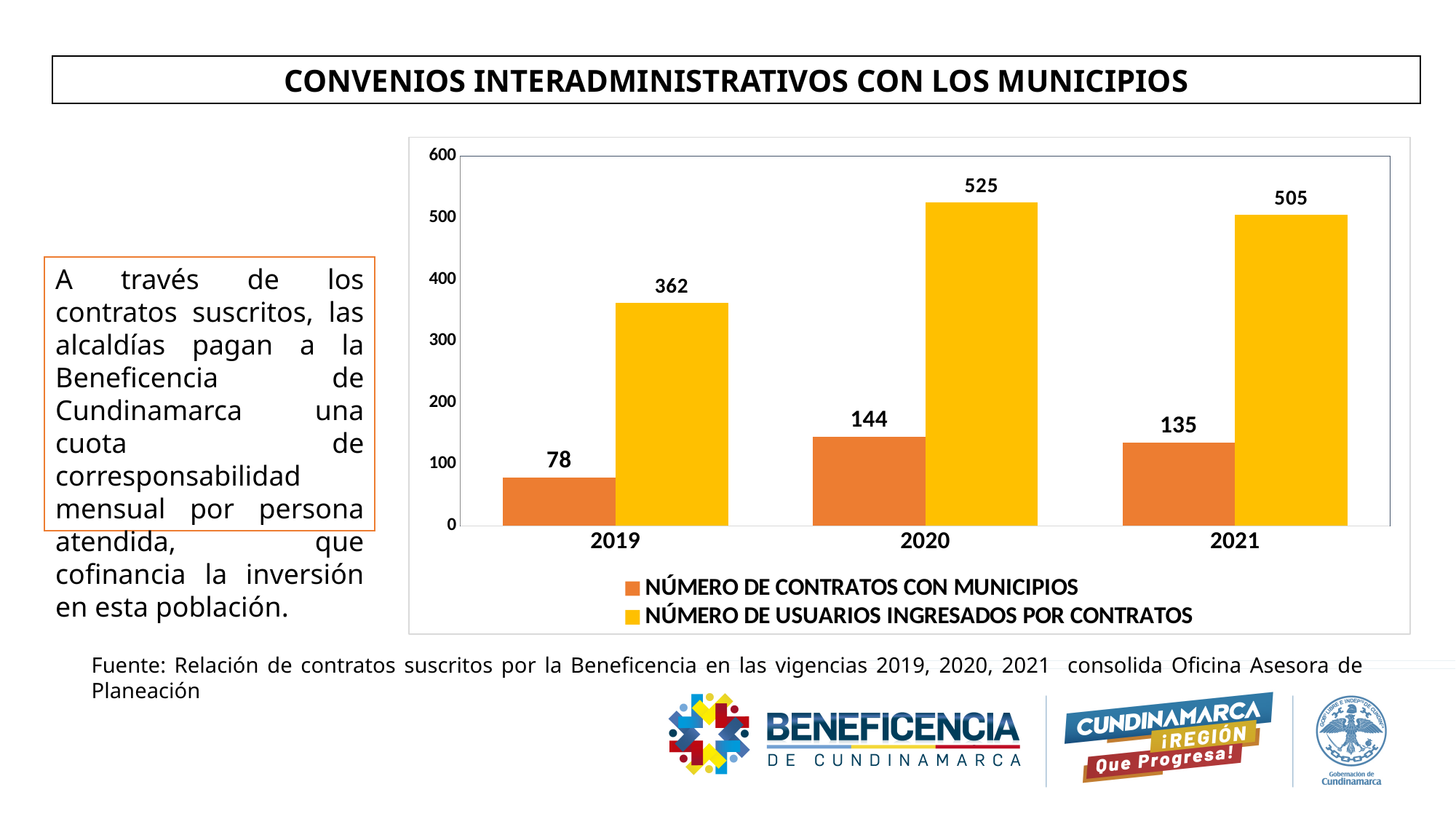
How many years are shown on the x axis of the chart? 3 What is the difference between NÚMERO DE CONTRATOS CON MUNICIPIOS in 2020 and 2019? 66 How many series does the chart legend list? 2 What is the value of NÚMERO DE USUARIOS INGRESADOS POR CONTRATOS for 2020? 525 What is the difference between NÚMERO DE USUARIOS INGRESADOS POR CONTRATOS in 2020 and 2021? 20 What kind of chart is shown on the slide? Bar chart What is the value of NÚMERO DE CONTRATOS CON MUNICIPIOS for 2019? 78 Which year has the highest value for NÚMERO DE CONTRATOS CON MUNICIPIOS? 2020 What is the value of NÚMERO DE USUARIOS INGRESADOS POR CONTRATOS for 2021? 505 Which year has the lowest value for NÚMERO DE USUARIOS INGRESADOS POR CONTRATOS? 2019 Is the value for NÚMERO DE USUARIOS INGRESADOS POR CONTRATOS in 2019 greater or less than 400? less Which is larger: NÚMERO DE CONTRATOS CON MUNICIPIOS in 2021 or in 2019? 2021